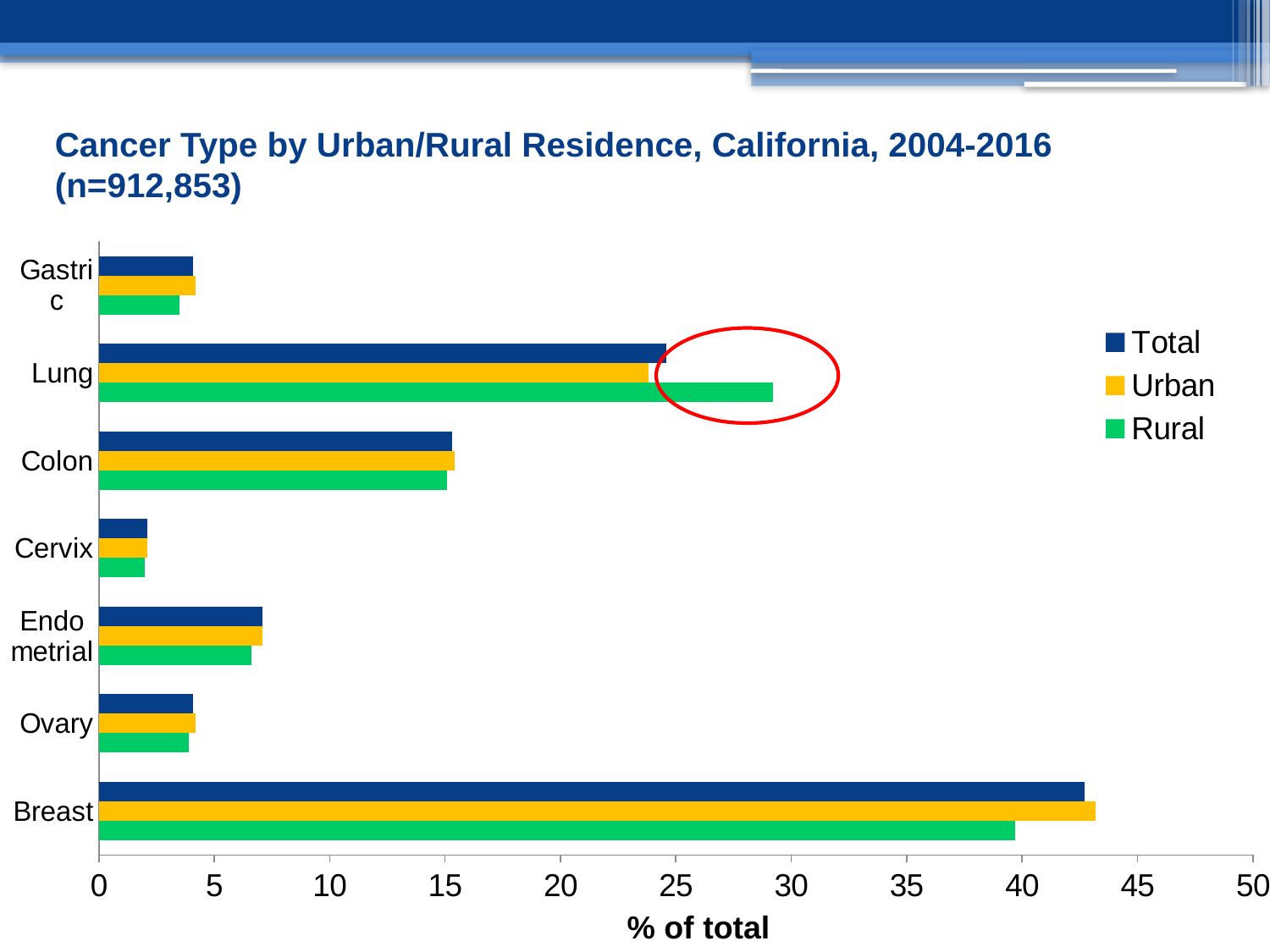
How many series does the legend list? 3 For Lung, which is larger: the Rural value or the Urban value? Rural For Breast, which is larger: the Urban value or the Rural value? Urban What is the label of the x axis? % of total Is the Urban value for Breast greater or less than 40? greater How many cancer types are shown on the y axis? 7 Which cancer type has the lowest Rural value? Cervix Is the Rural value for Lung greater or less than 25? greater Which cancer type has the highest Total value? Breast What kind of chart is shown on the slide? bar chart Which cancer type's bar is circled in red on the chart? Lung Is the Urban value for Lung greater or less than 25? less